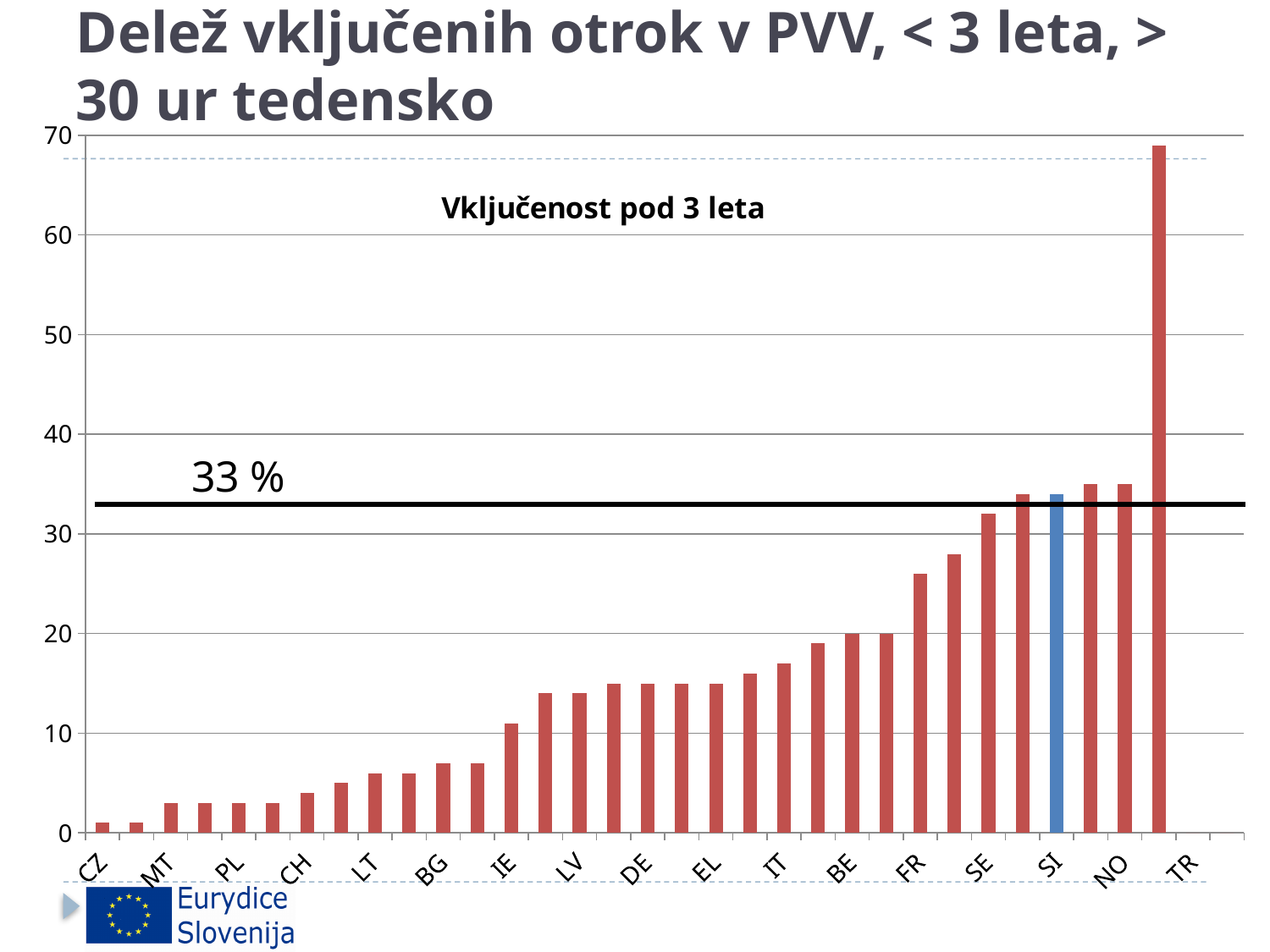
Which has a larger value, FR or BE? FR Is the value for BE greater or less than 30? less Is the value for NO greater or less than 30? greater Is the value for DE greater or less than 10? greater What value is marked by the horizontal black line across the chart? 33 % Do the values generally rise or fall from left to right along the x axis? rise Which country's bar is coloured blue instead of red? SI What kind of chart is shown on the slide? bar chart